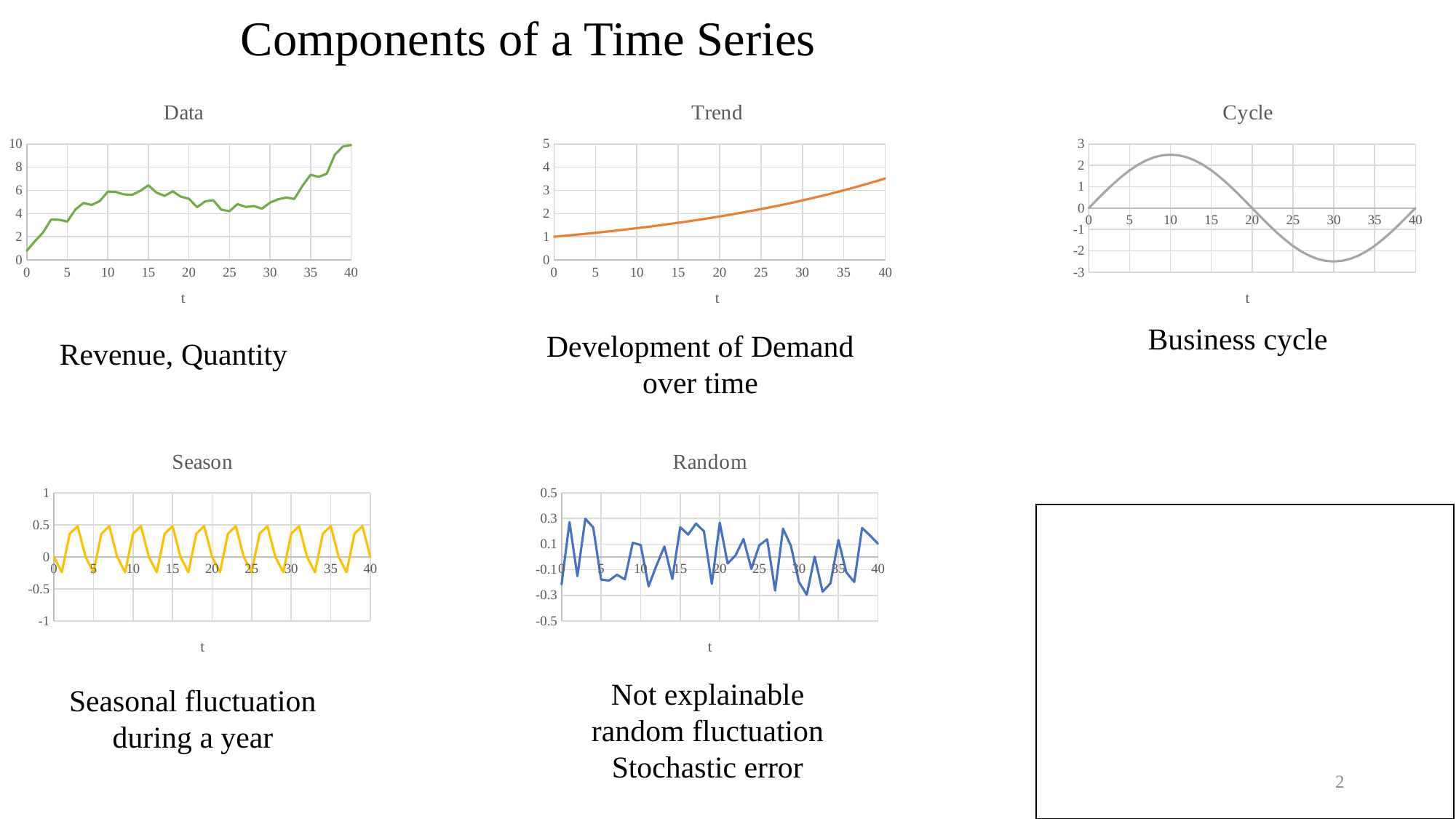
In the "Data" chart, is the value at t = 40 greater or less than 8? greater In the "Cycle" chart, is the value at t = 10 greater or less than 2? greater What is the title of the chart in the top-right position of the slide? Cycle In the "Data" chart, is the value at t = 0 greater or less than 2? less What kind of chart is the "Data" chart? line chart In the "Cycle" chart, what is the value at t = 20? 0 How many charts are shown on the slide? 5 In the "Trend" chart, what is the value at t = 0? 1 In the "Trend" chart, do the values rise or fall as t increases from 0 to 40? rise